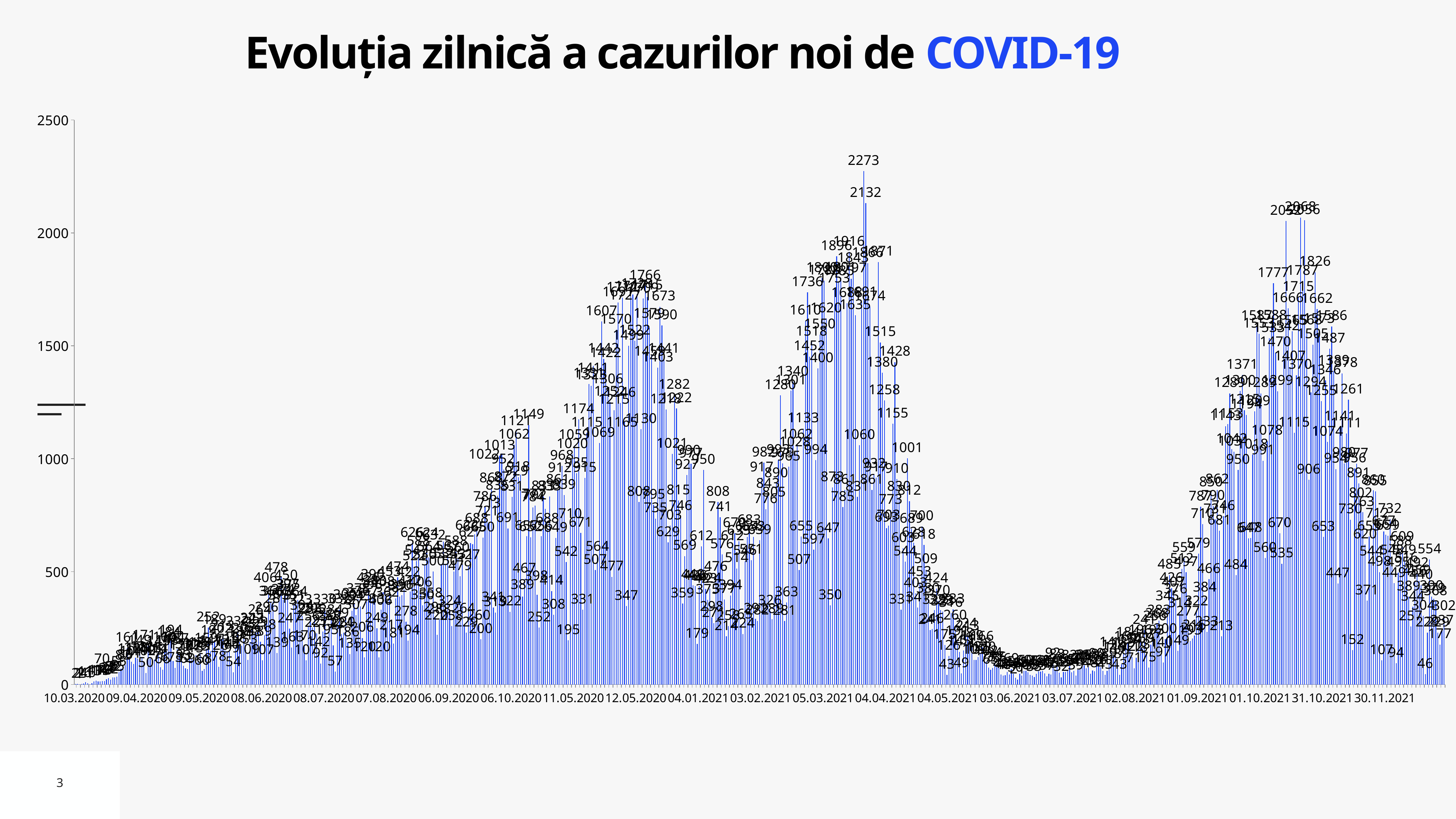
Between 04.04.2021 and 03.06.2021, do the daily values generally rise or fall? fall What is the title of the chart? Evoluția zilnică a cazurilor noi de COVID-19 What is the topmost value shown on the vertical axis? 2500 What is the difference between the two highest labelled values, 2273 and 2132? 141 Is the highest bar on the chart greater or less than 2000? greater What is the highest daily value labelled on the chart? 2273 Are the values around 03.07.2021 greater or less than 500? less What kind of chart is shown on the slide? bar chart What is the last date label on the horizontal axis? 30.11.2021 Which is larger: the highest value labelled in the peak near 04.04.2021 (2273) or the highest value labelled in the peak near 12.05.2020 (1766)? 2273 What is the first date label on the horizontal axis? 10.03.2020 Between 02.08.2021 and 01.10.2021, do the daily values generally rise or fall? rise